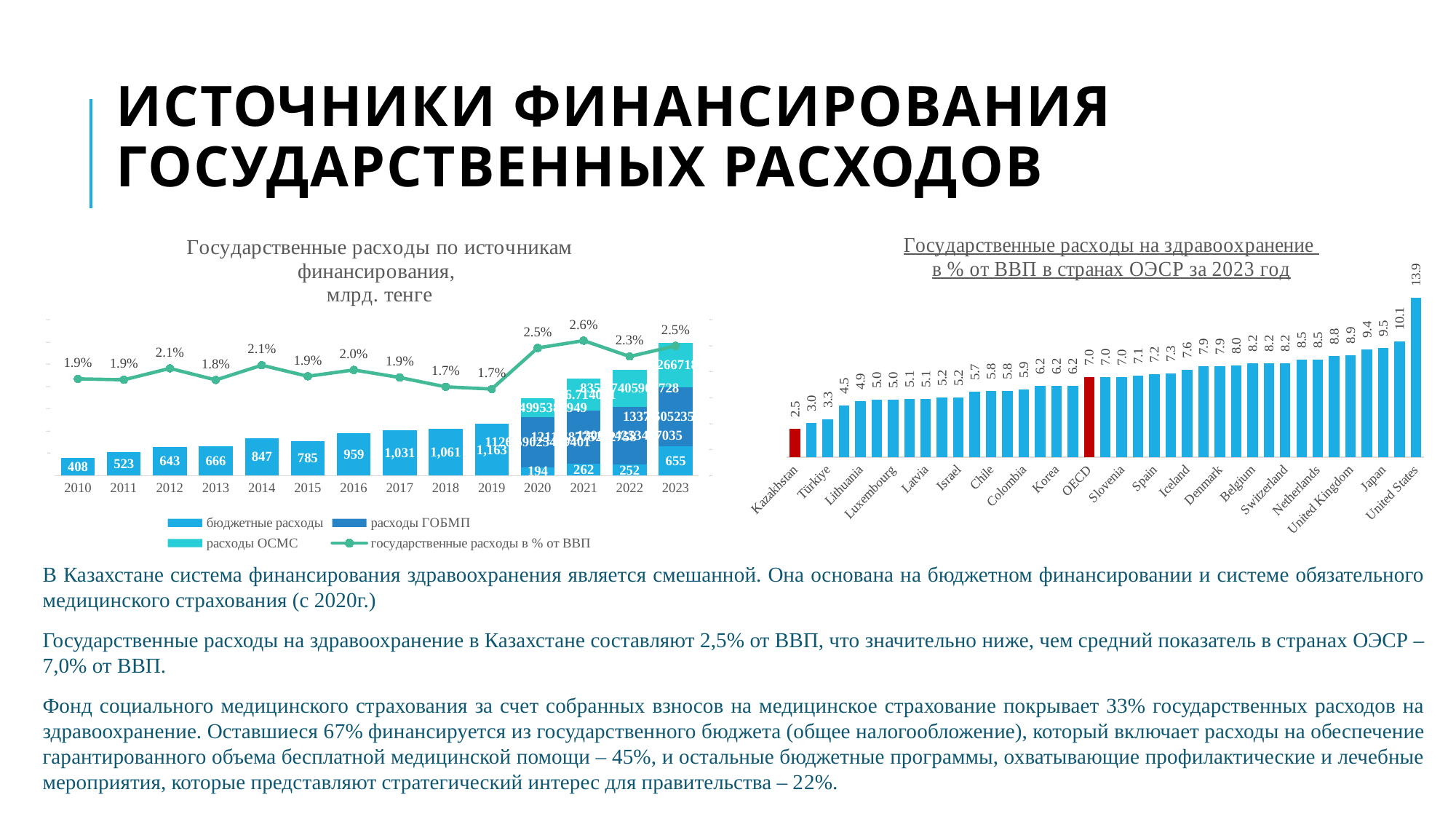
In the left chart, which year has the larger value of бюджетные расходы, 2015 or 2016? 2016 In the left chart, in which year does the line государственные расходы в % от ВВП reach its highest value? 2021 In the left chart, what is the difference between бюджетные расходы in 2011 and in 2010? 115 What kind of chart is the left chart, 'Государственные расходы по источникам финансирования, млрд. тенге'? A stacked bar chart with a line In the right chart, which country has the highest value? United States In the right chart, what is the value for OECD? 7.0 In the left chart, what is the value of государственные расходы в % от ВВП for 2021? 2.6% In the left chart, does the line государственные расходы в % от ВВП rise or fall from 2017 to 2019? Fall In the right chart, 'Государственные расходы на здравоохранение в % от ВВП в странах ОЭСР за 2023 год', what is the value for Kazakhstan? 2.5 How many years are shown on the x axis of the left chart? 14 How many series does the legend of the left chart list? 4 In the left chart, what is the value of бюджетные расходы for 2010? 408